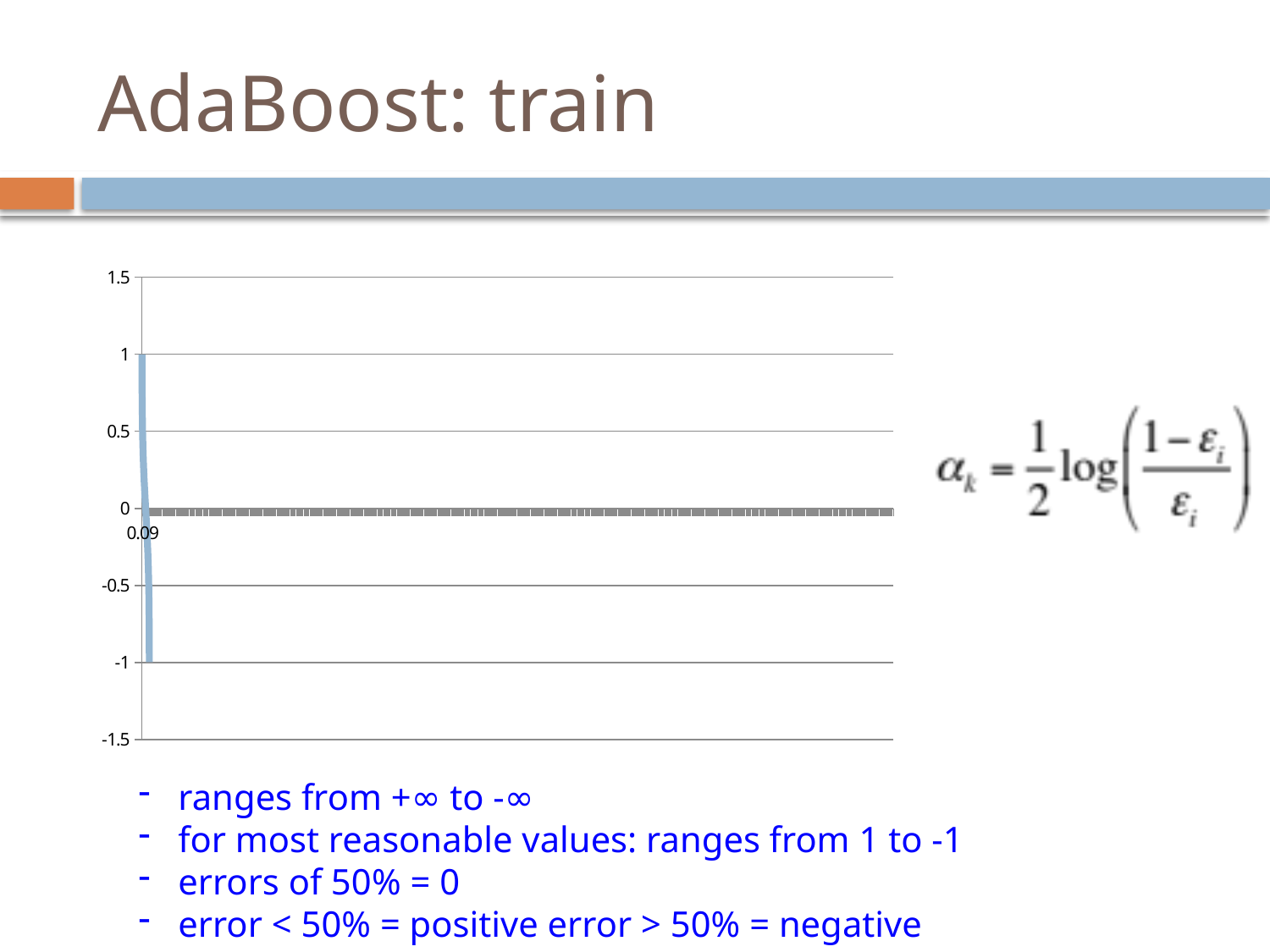
Do the plotted values rise or fall as you move along the x axis? fall What is the lowest tick value shown on the y axis? -1.5 Is the lowest plotted value of the line greater or less than -0.5? less Is the highest plotted value of the line greater or less than 0.5? greater Is the ending value of the line greater or less than 0? less What kind of chart is shown on the slide? line chart What is the highest tick value shown on the y axis? 1.5